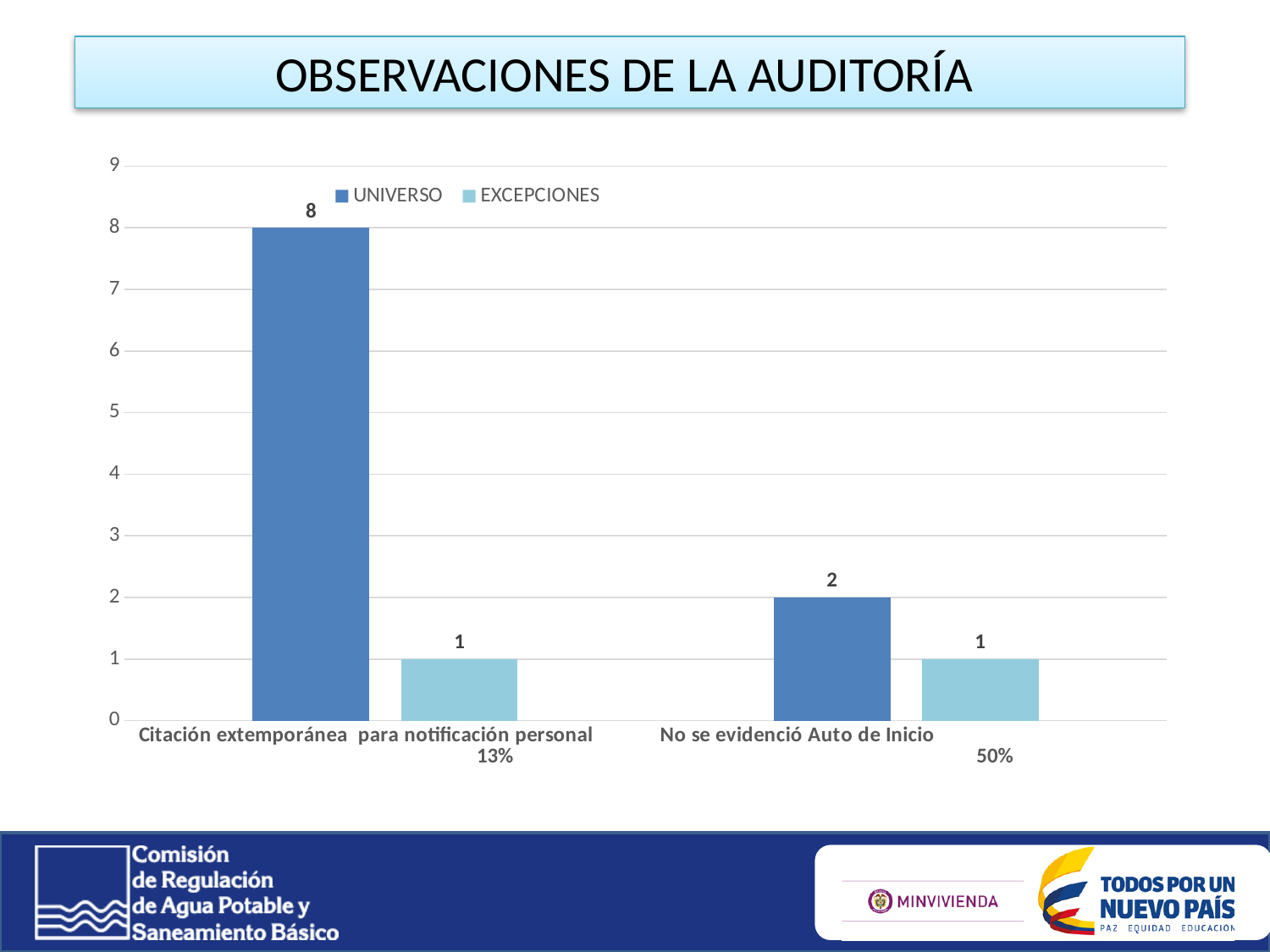
What kind of chart is shown on the slide? Bar chart What is the UNIVERSO value for "Citación extemporánea para notificación personal"? 8 What is the UNIVERSO value for "No se evidenció Auto de Inicio"? 2 What is the difference between the UNIVERSO and EXCEPCIONES values for "Citación extemporánea para notificación personal"? 7 What percentage is printed under the "No se evidenció Auto de Inicio" category? 50% What is the EXCEPCIONES value for "No se evidenció Auto de Inicio"? 1 How many categories are shown on the x axis? 2 How many series does the legend list? 2 What are the two series named in the legend? UNIVERSO and EXCEPCIONES What is the difference between the UNIVERSO values of the two categories? 6 Which is larger: the UNIVERSO value for "Citación extemporánea para notificación personal" or the UNIVERSO value for "No se evidenció Auto de Inicio"? Citación extemporánea para notificación personal Which category has the highest UNIVERSO value? Citación extemporánea para notificación personal